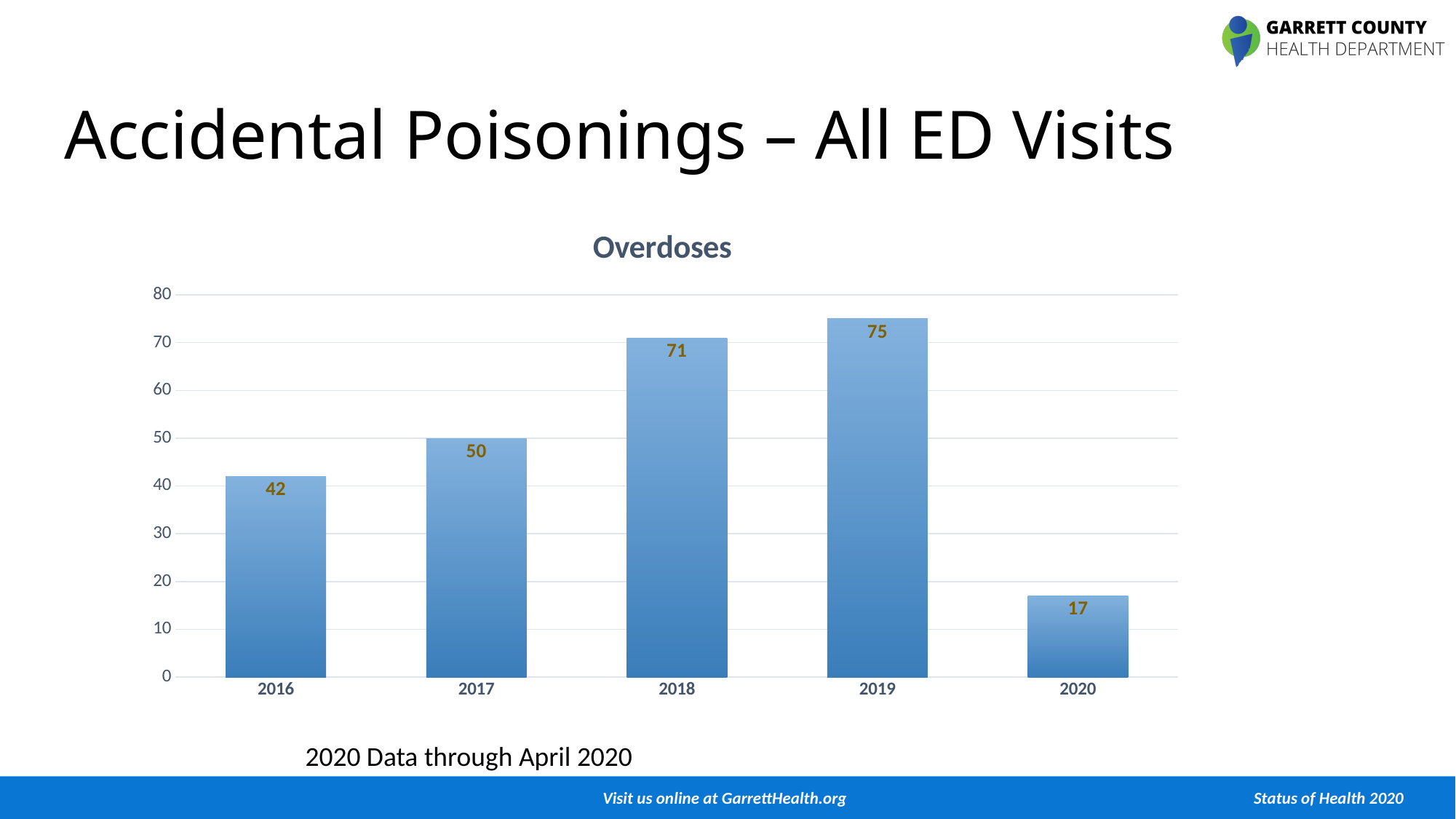
Which year has the highest number of overdoses? 2019 What kind of chart is shown on the slide? bar chart What is the number of overdoses shown for 2020? 17 What is the value for 2016? 42 What is the number of overdoses shown for 2018? 71 Is the value for 2019 greater or less than 70? greater What is the difference between the 2019 and 2016 values? 33 Which year has the lowest number of overdoses? 2020 Which is larger, the value for 2017 or the value for 2018? 2018 What is the difference between the 2017 and 2020 values? 33 What is the title of the chart? Overdoses How many years are shown on the x axis? 5